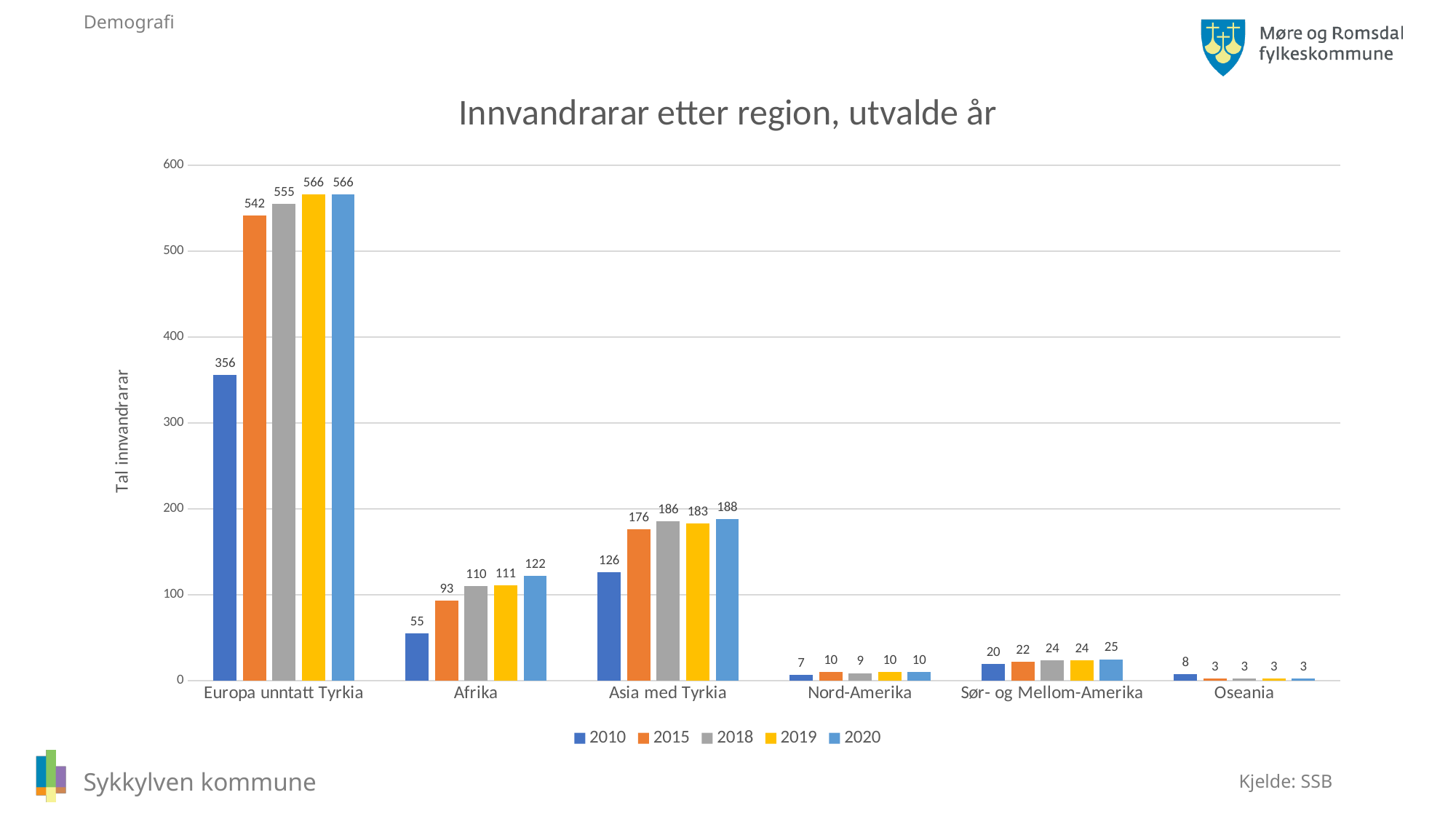
Is the value for Europa unntatt Tyrkia in 2015 greater or less than 500? greater Which region has the highest value in 2020? Europa unntatt Tyrkia What is the value for Sør- og Mellom-Amerika in 2018? 24 Which region has the lowest value in 2015? Oseania How many series does the legend list? 5 What is the value for Europa unntatt Tyrkia in 2010? 356 How many regions are shown on the x axis? 6 Which is larger for Afrika: the 2015 value or the 2018 value? 2018 What is the difference between the 2020 and 2010 values for Asia med Tyrkia? 62 What is the title of the chart? Innvandrarar etter region, utvalde år What is the value for Afrika in 2020? 122 What kind of chart is shown? bar chart